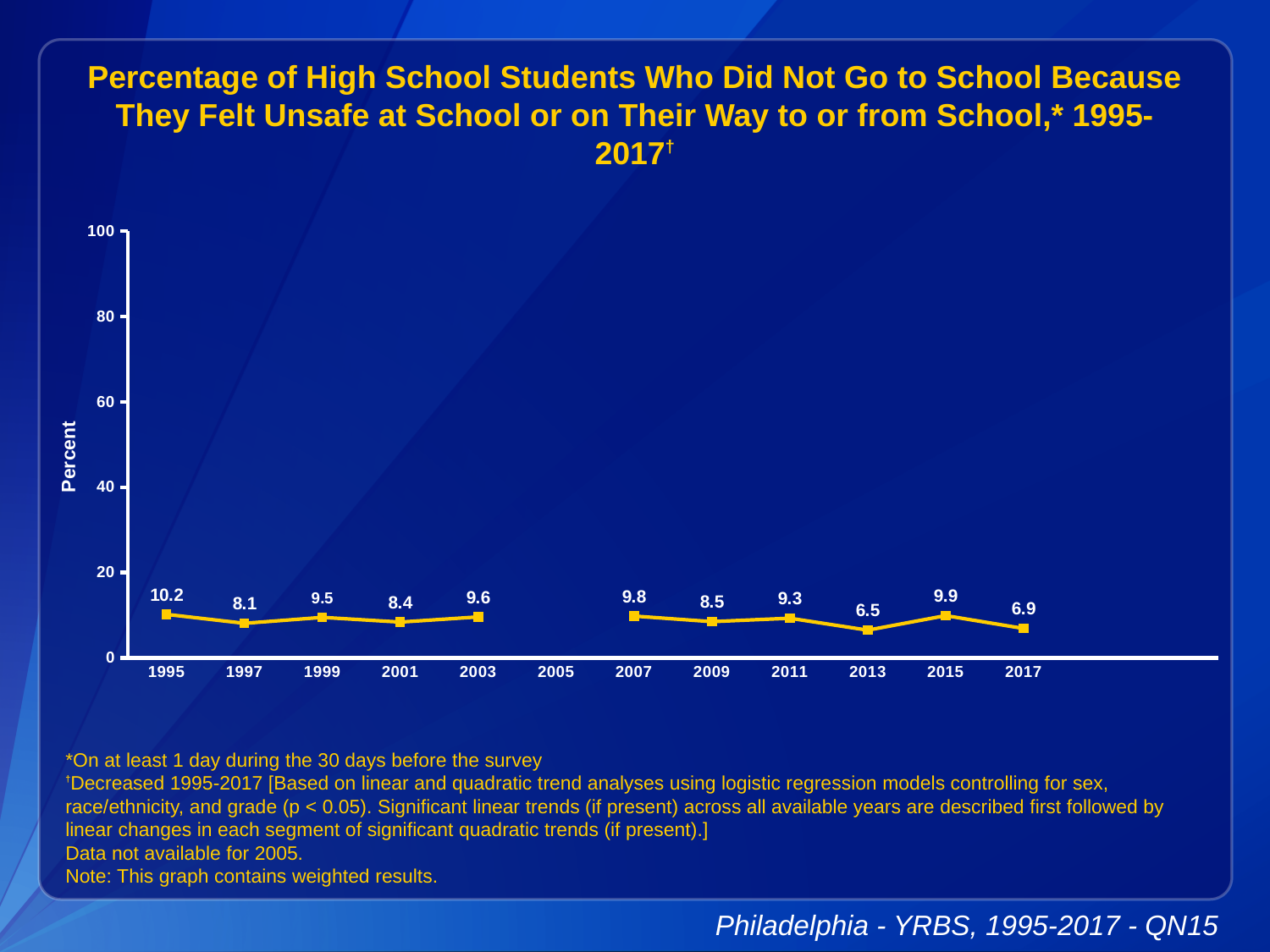
Which year on the x axis has no data point plotted? 2005 Which is larger, the value for 2015 or the value for 2011? 2015 What is the value for 2017? 6.9 Which year has the highest value? 1995 What is the label of the y axis? Percent What is the difference between the values for 1995 and 2017? 3.3 What is the value for 2013? 6.5 How many years have data points plotted on the chart? 11 Which year has the lowest value? 2013 What is the value for 1995? 10.2 What kind of chart is shown on the slide? line chart Is the value for 2007 greater or less than 20? less